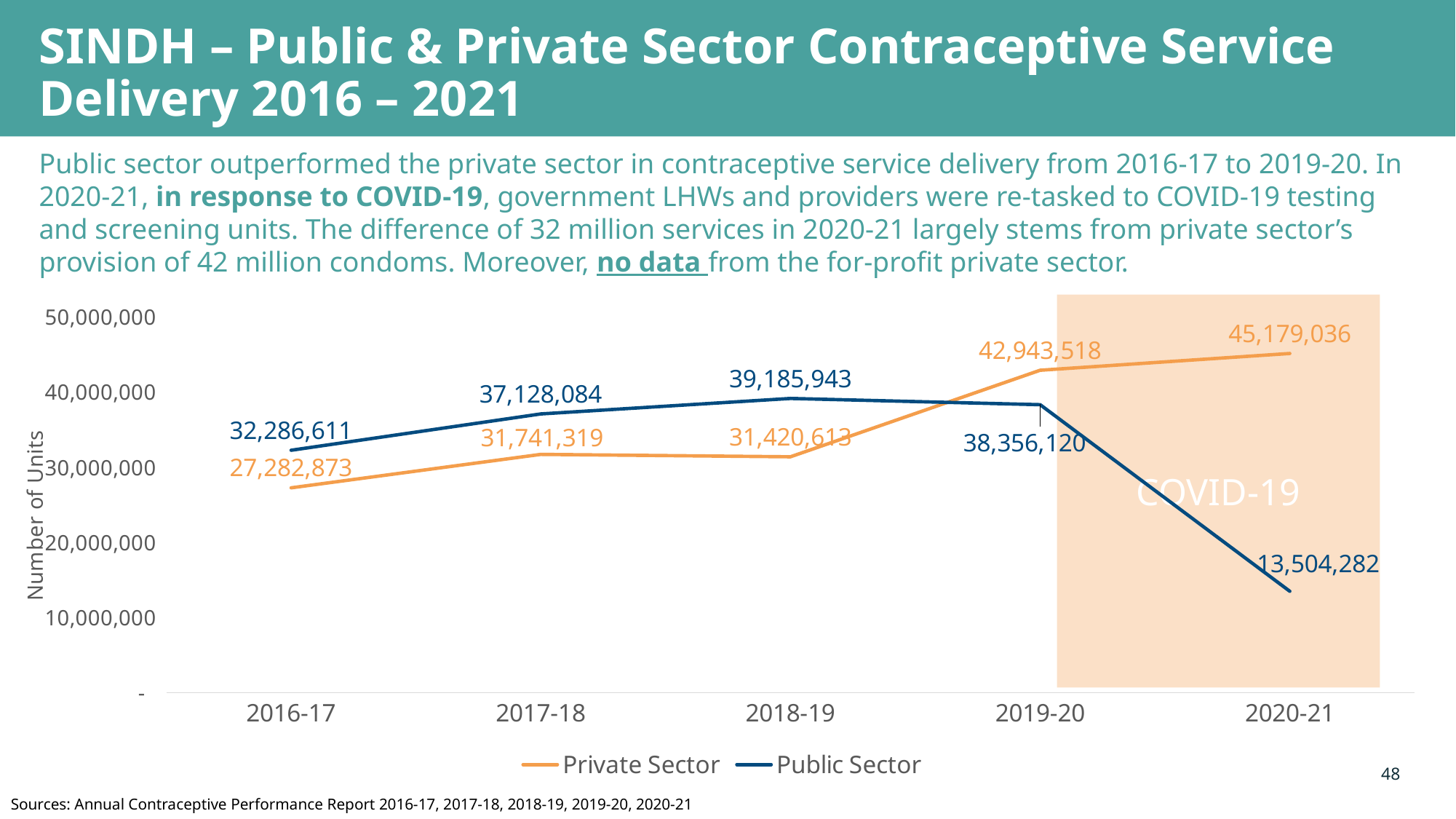
In which year does the Private Sector reach its highest value? 2020-21 Which sector has the larger value in 2017-18? Public Sector Which colour is used for the Private Sector line? Orange In which year is the Public Sector value lowest? 2020-21 How many series does the legend list? 2 What kind of chart is shown on the slide? Line chart What is the Public Sector value for 2020-21? 13,504,282 How many years are shown on the x axis? 5 What is the Private Sector value for 2019-20? 42,943,518 What is the Private Sector value for 2016-17? 27,282,873 What is the Public Sector value for 2018-19? 39,185,943 What is the difference between the Private Sector and Public Sector values in 2020-21? 31,674,754